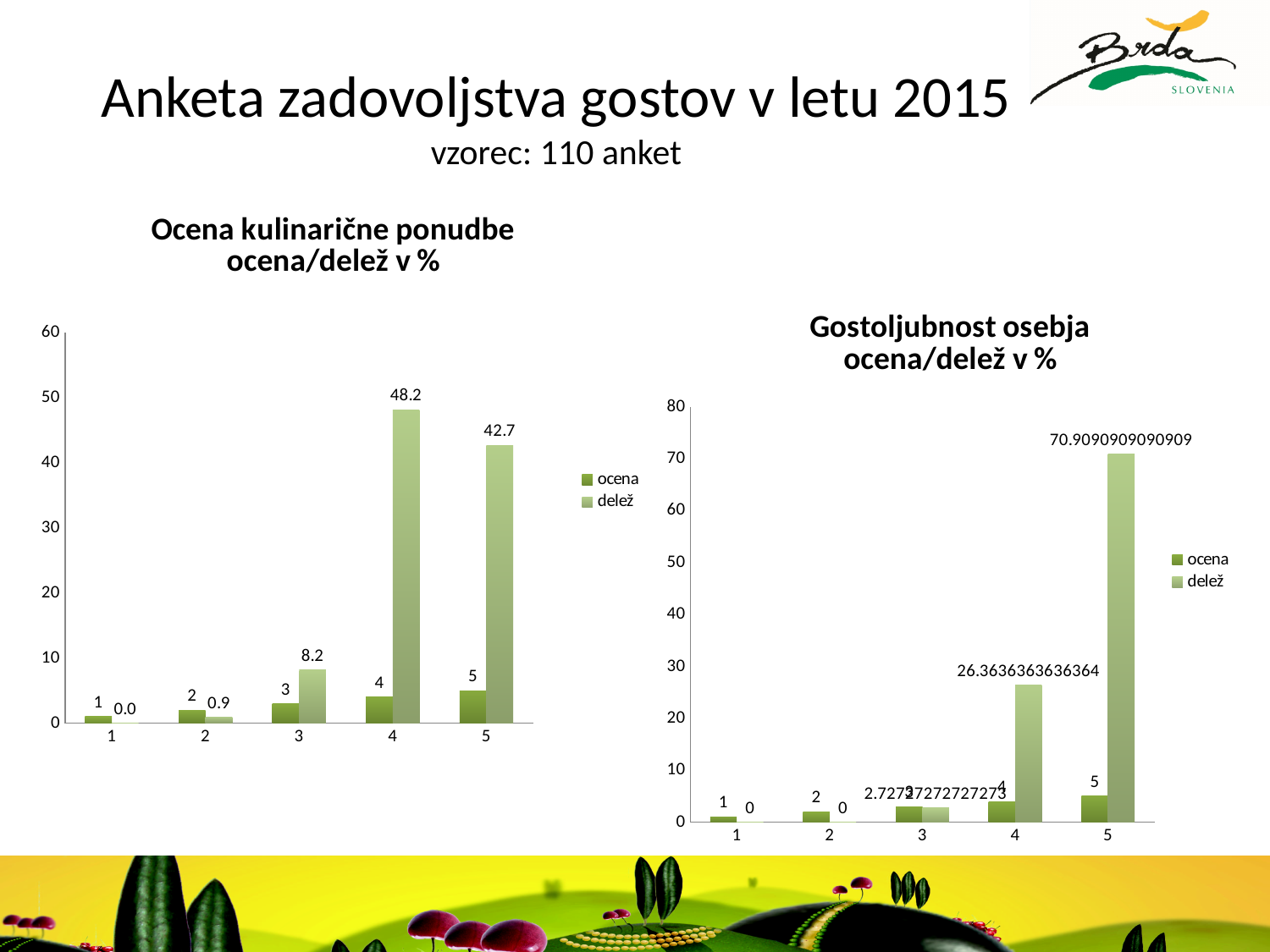
In the 'Ocena kulinarične ponudbe' chart, which category has the highest delež value? 4 In the 'Ocena kulinarične ponudbe' chart, what is the delež value for category 4? 48.2 In the 'Ocena kulinarične ponudbe' chart, how many series does the legend list? 2 What type of chart is the 'Gostoljubnost osebja' chart? bar chart In the 'Gostoljubnost osebja' chart, how many categories are shown on the x axis? 5 In the 'Gostoljubnost osebja' chart, what is the delež value for category 4? 26.3636363636364 In the 'Gostoljubnost osebja' chart, what is the delež value for category 5? 70.9090909090909 In the 'Ocena kulinarične ponudbe' chart, what is the delež value for category 5? 42.7 In the 'Gostoljubnost osebja' chart, is the delež value for category 5 greater or less than 70? greater In the 'Gostoljubnost osebja' chart, which category has the highest delež value? 5 In the 'Ocena kulinarične ponudbe' chart, what is the difference between the delež values for categories 4 and 5? 5.5 In the 'Ocena kulinarične ponudbe' chart, is the delež value for category 4 larger than the delež value for category 3? Yes